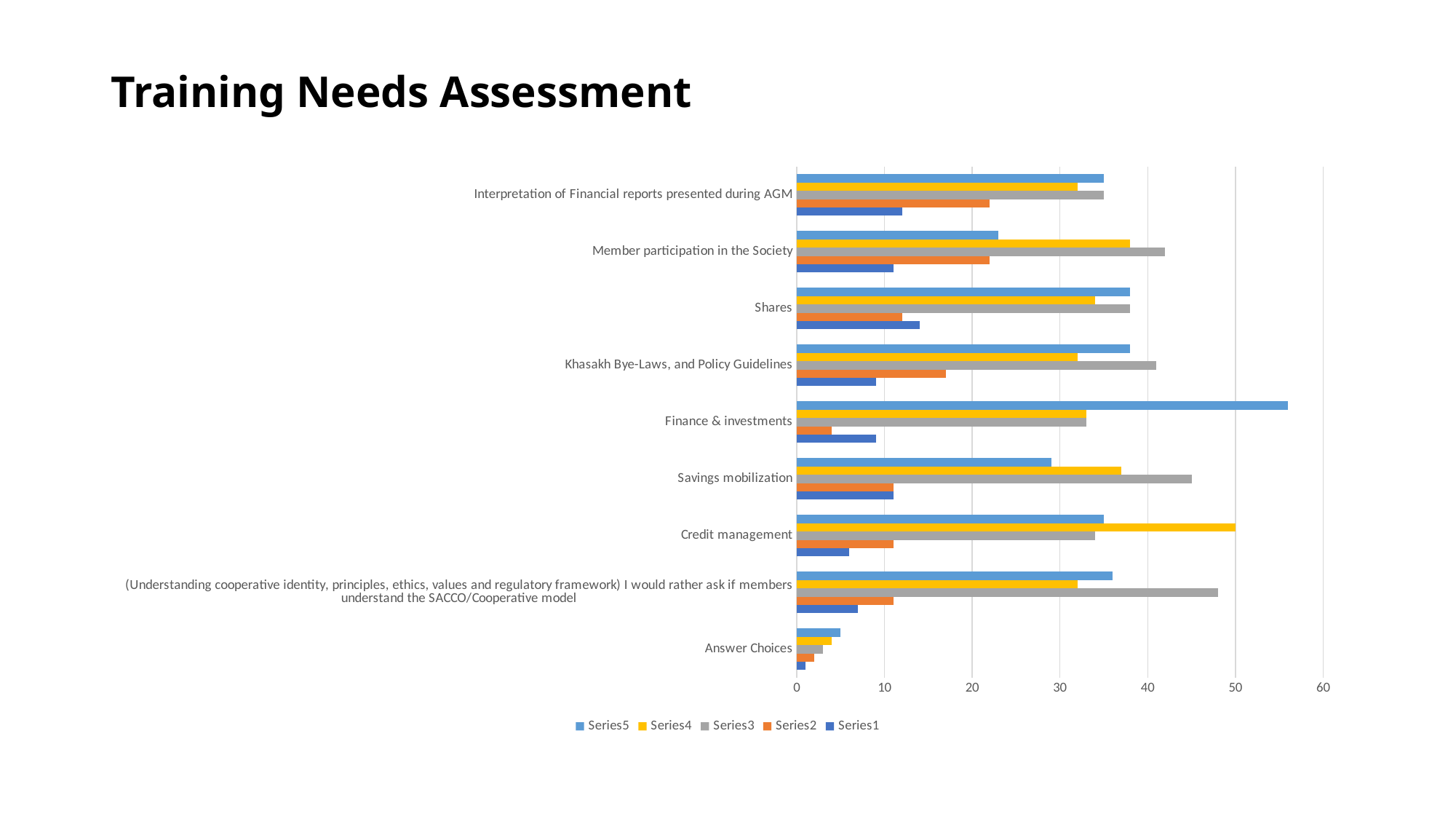
Which category has the highest Series5 value? Finance & investments Is the Series2 value for Finance & investments greater or less than 10? less Is the Series4 value for Credit management greater or less than 40? greater Which category has the lowest Series3 value? Answer Choices How many series does the legend list? 5 Which is larger: the Series5 value for Finance & investments or the Series5 value for Member participation in the Society? Finance & investments How many categories are plotted on the chart? 9 What kind of chart is shown on the slide? bar chart Is the Series5 value for Finance & investments greater or less than 50? greater What is the title of the slide containing the chart? Training Needs Assessment Which is larger: the Series3 value for Savings mobilization or the Series3 value for Shares? Savings mobilization